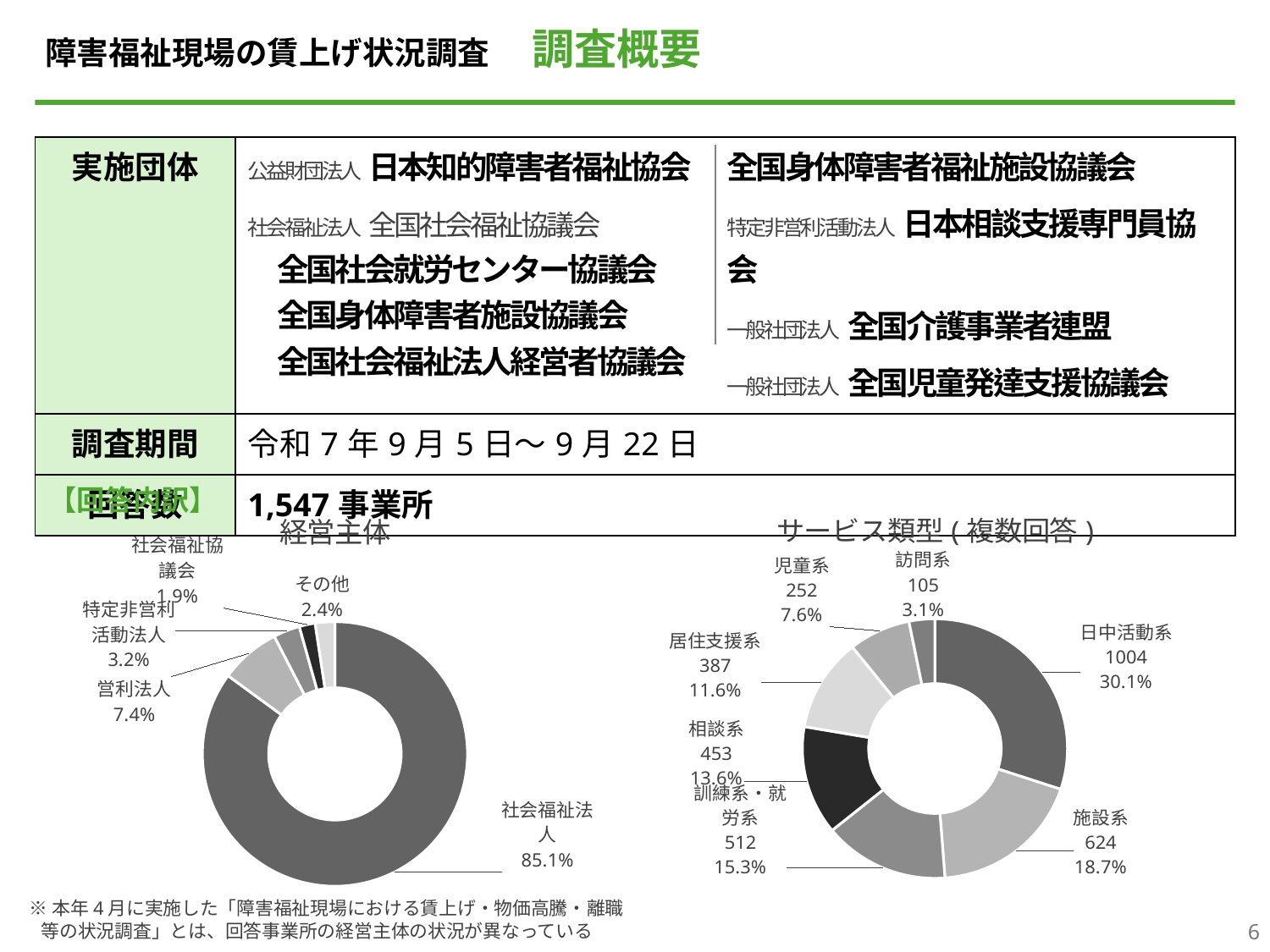
In the サービス類型(複数回答) chart, what is the difference between the values for 施設系 and 訓練系・就労系? 112 In the 経営主体 chart, which category has the smallest share? 社会福祉協議会 In the 経営主体 chart, how many categories are shown? 5 In the サービス類型(複数回答) chart, which is larger, 相談系 or 居住支援系? 相談系 In the サービス類型(複数回答) chart, which category has the lowest value? 訪問系 What kind of chart is the 経営主体 chart? Doughnut chart In the 経営主体 chart, what percentage is shown for 営利法人? 7.4% In the サービス類型(複数回答) chart, what is the value for 日中活動系? 1004 In the サービス類型(複数回答) chart, how many categories are shown? 7 In the サービス類型(複数回答) chart, what percentage is shown for 施設系? 18.7% In the サービス類型(複数回答) chart, which category has the highest value? 日中活動系 In the 経営主体 chart, what percentage is shown for 社会福祉法人? 85.1%